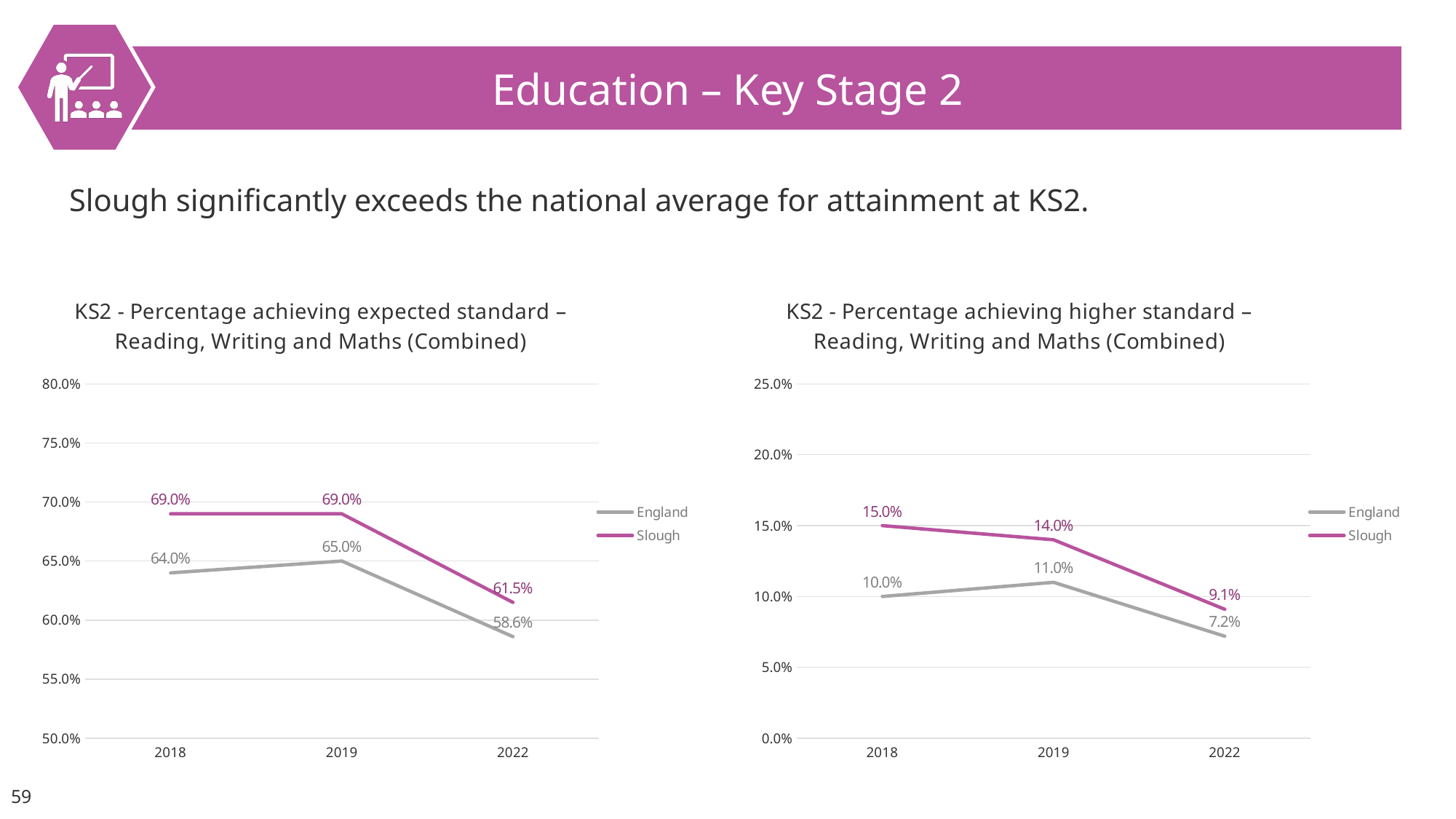
In the 'KS2 - Percentage achieving higher standard' chart, which year has the highest value for Slough? 2018 In the 'KS2 - Percentage achieving expected standard' chart, which year has the lowest value for England? 2022 In the 'KS2 - Percentage achieving higher standard' chart, what is the value for England in 2022? 7.2% In the 'KS2 - Percentage achieving higher standard' chart, what is the difference between Slough and England in 2019? 3.0% In the 'KS2 - Percentage achieving higher standard' chart, which is larger in 2022, Slough or England? Slough In the 'KS2 - Percentage achieving expected standard' chart, does the Slough line rise or fall between 2019 and 2022? Fall How many series does the legend list in the 'KS2 - Percentage achieving expected standard' chart? 2 What kind of chart is the 'KS2 - Percentage achieving higher standard' chart? Line chart In the 'KS2 - Percentage achieving expected standard' chart, what is the difference between Slough and England in 2018? 5.0% In the 'KS2 - Percentage achieving expected standard' chart, what is the value for Slough in 2022? 61.5% In the 'KS2 - Percentage achieving higher standard' chart, what is the value for Slough in 2018? 15.0% In the 'KS2 - Percentage achieving expected standard' chart, what is the value for England in 2019? 65.0%